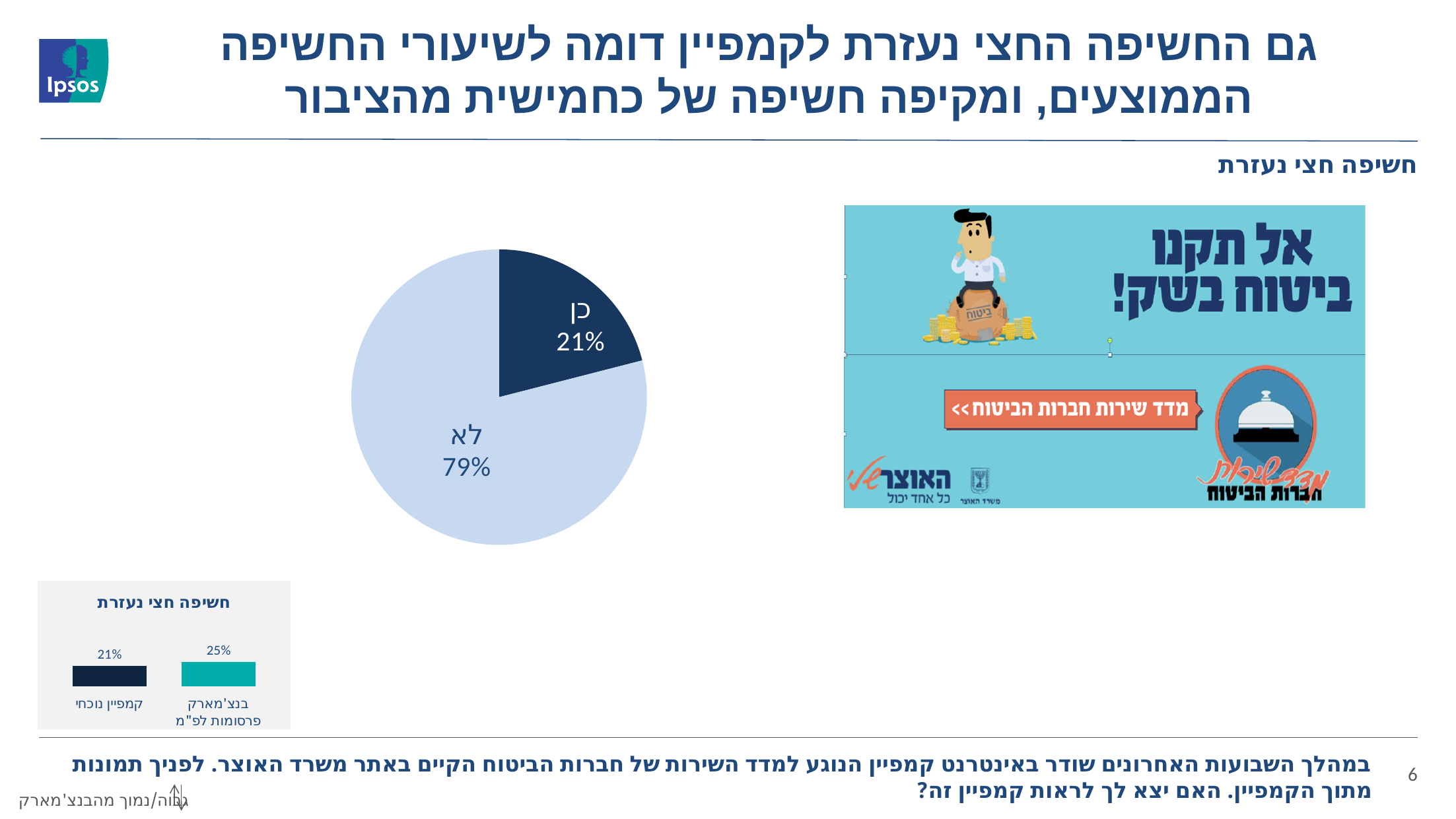
In the small bar chart at the bottom left, which bar is higher: קמפיין נוכחי or בנצ'מארק פרסומות לפ"מ? בנצ'מארק פרסומות לפ"מ In the pie chart, which slice is the largest? לא What is the title of the small bar chart at the bottom left of the slide? חשיפה חצי נעזרת In the small bar chart at the bottom left, what is the value for קמפיין נוכחי? 21% In the pie chart, what is the difference in percentage points between the לא slice and the כן slice? 58 In the pie chart, what share of respondents answered כן? 21% What kind of chart is the large chart on the left side of the slide? pie chart In the small bar chart at the bottom left, what is the difference in percentage points between בנצ'מארק פרסומות לפ"מ and קמפיין נוכחי? 4 In the pie chart, what share of respondents answered לא? 79% In the small bar chart at the bottom left, what is the value for בנצ'מארק פרסומות לפ"מ? 25% In the pie chart, which slice is the smallest? כן In the pie chart, how many slices are there? 2